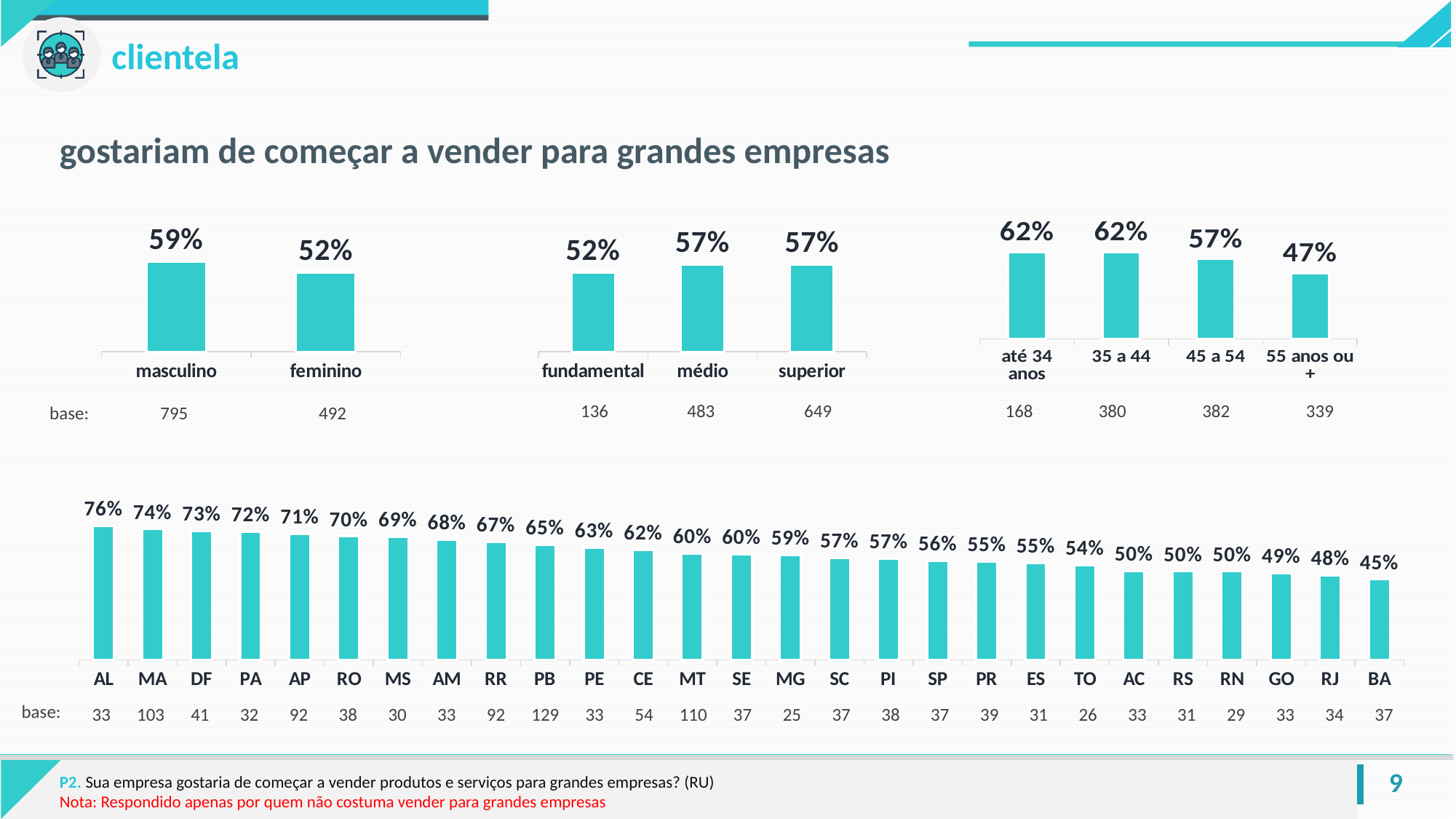
In the top-left chart (gender), what is the difference between masculino and feminino? 7% In the top-middle chart (education level), how many categories are shown? 3 In the top-right chart (age groups), which category has the lowest value? 55 anos ou + In the top-left chart (gender), what is the value for masculino? 59% In the top-middle chart (education level), what is the value for fundamental? 52% In the top-left chart (gender), which category has the lower value? feminino What kind of chart is the bottom chart (states)? bar chart In the top-right chart (age groups), what is the difference between 45 a 54 and 55 anos ou +? 10% In the bottom chart (states), which is larger, the value for PB or the value for SP? PB In the bottom chart (states), which state has the highest value? AL In the bottom chart (states), what is the value for MT? 60% In the top-right chart (age groups), what is the value for 55 anos ou +? 47%